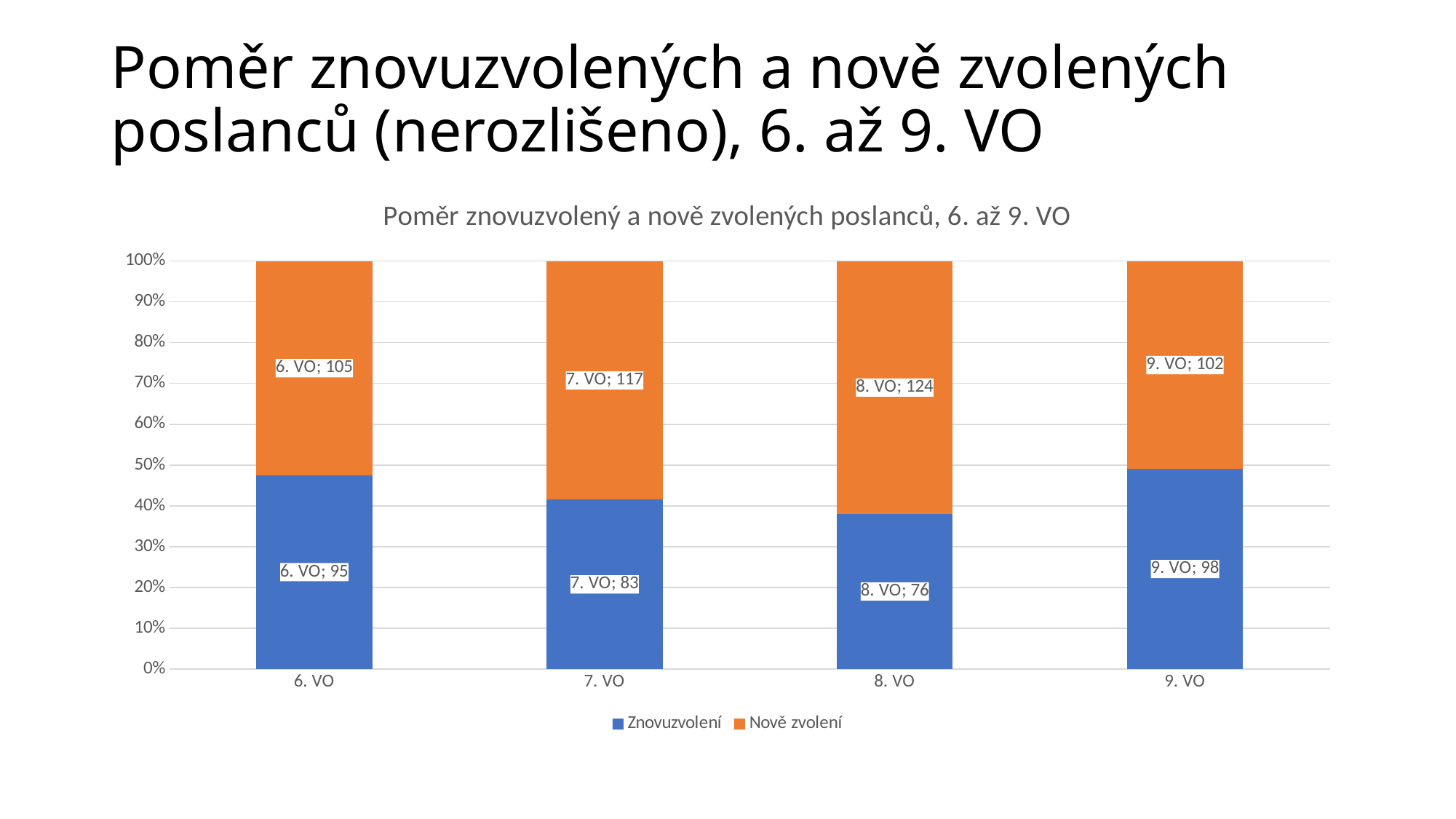
Which category has the lowest value for Znovuzvolení? 8. VO What kind of chart is shown on the slide? stacked bar chart Which is larger for 9. VO: Znovuzvolení or Nově zvolení? Nově zvolení How many categories are shown on the x axis? 4 What is the difference between Nově zvolení and Znovuzvolení for 7. VO? 34 Is the share of Znovuzvolení for 8. VO greater or less than 40%? less What is the total of Znovuzvolení and Nově zvolení for 6. VO? 200 What is the value of Znovuzvolení for 6. VO? 95 What is the value of Nově zvolení for 8. VO? 124 Which category has the highest value for Nově zvolení? 8. VO What is the value of Znovuzvolení for 9. VO? 98 How many series does the legend list? 2